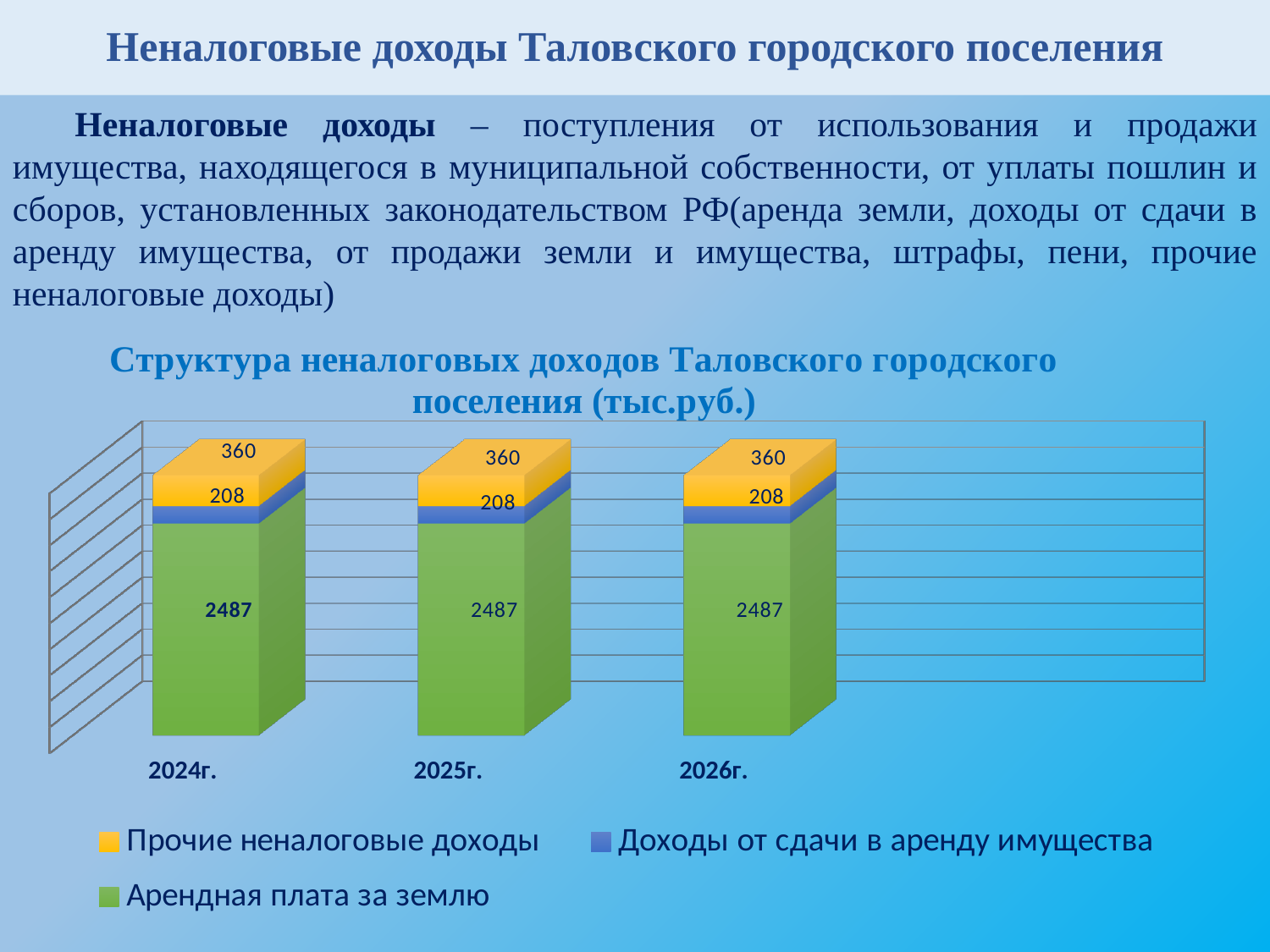
How many series does the legend list? 3 Which is larger in 2024г.: Прочие неналоговые доходы or Доходы от сдачи в аренду имущества? Прочие неналоговые доходы Which series has the smallest value in 2025г.? Доходы от сдачи в аренду имущества What is the value for Доходы от сдачи в аренду имущества in 2026г.? 208 How many years are shown on the x axis of the chart? 3 What is the difference between Арендная плата за землю and Прочие неналоговые доходы in 2025г.? 2127 What is the total of the stacked bar for 2026г.? 3055 What is the total of the stacked bar for 2024г.? 3055 Which series has the largest value in 2026г.? Арендная плата за землю What is the value for Прочие неналоговые доходы in 2025г.? 360 What is the value for Арендная плата за землю in 2024г.? 2487 What is the difference between Прочие неналоговые доходы and Доходы от сдачи в аренду имущества in 2024г.? 152